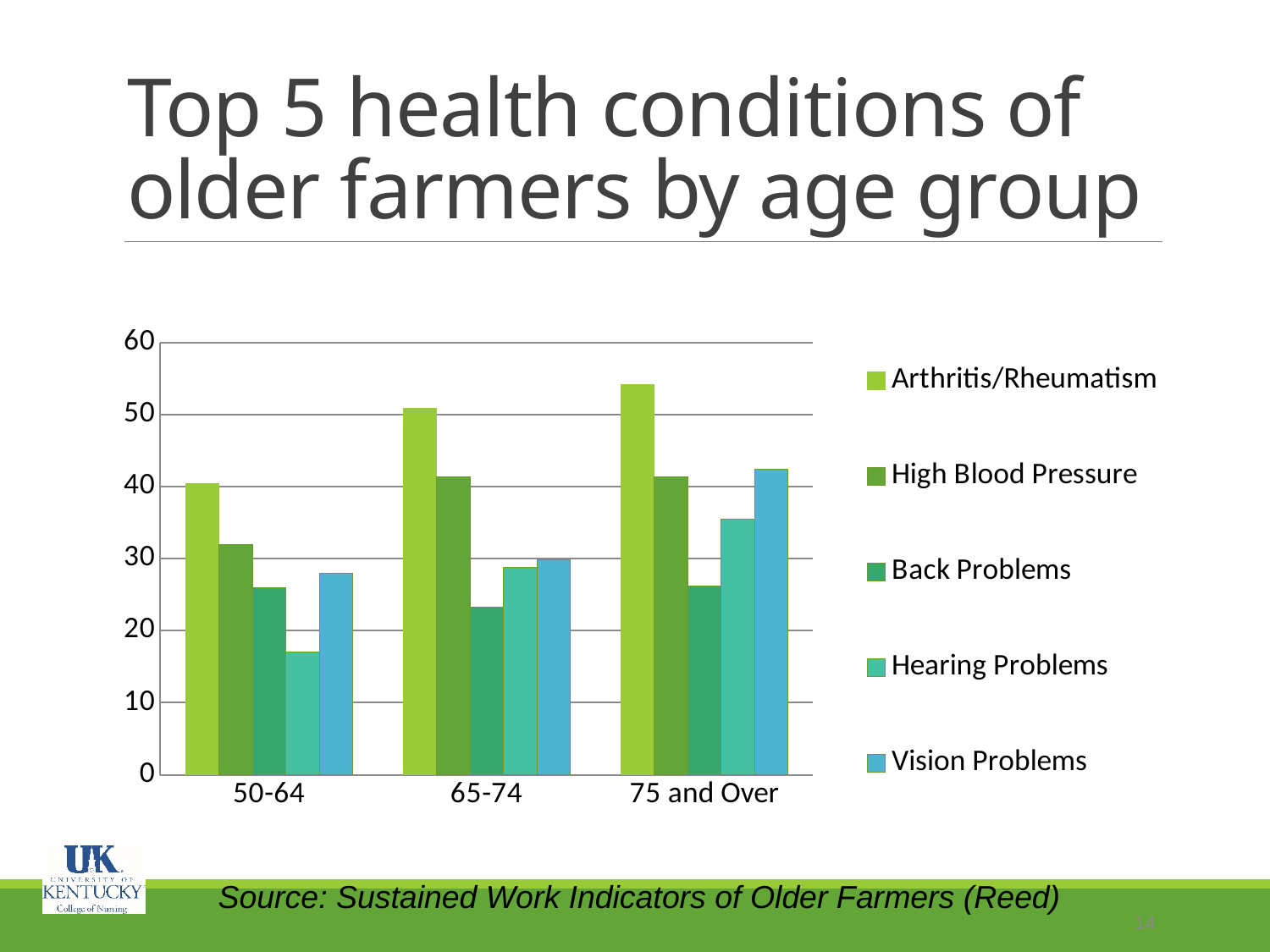
How many age groups are shown on the x axis? 3 What kind of chart is shown on the slide? bar chart How many series does the legend list? 5 Which is larger: Vision Problems for 75 and Over or Vision Problems for 50-64? 75 and Over Is the value for Hearing Problems in the 50-64 group greater or less than 20? less Which health condition has the lowest value for the 65-74 age group? Back Problems Which health condition has the lowest value for the 50-64 age group? Hearing Problems Which health condition has the highest value for the 75 and Over age group? Arthritis/Rheumatism Is the value for High Blood Pressure in the 50-64 group greater or less than 30? greater Is the value for Arthritis/Rheumatism in the 75 and Over group greater or less than 50? greater What is the highest value shown on the y axis? 60 Does the value for Arthritis/Rheumatism rise or fall as the age group increases from 50-64 to 75 and Over? rises